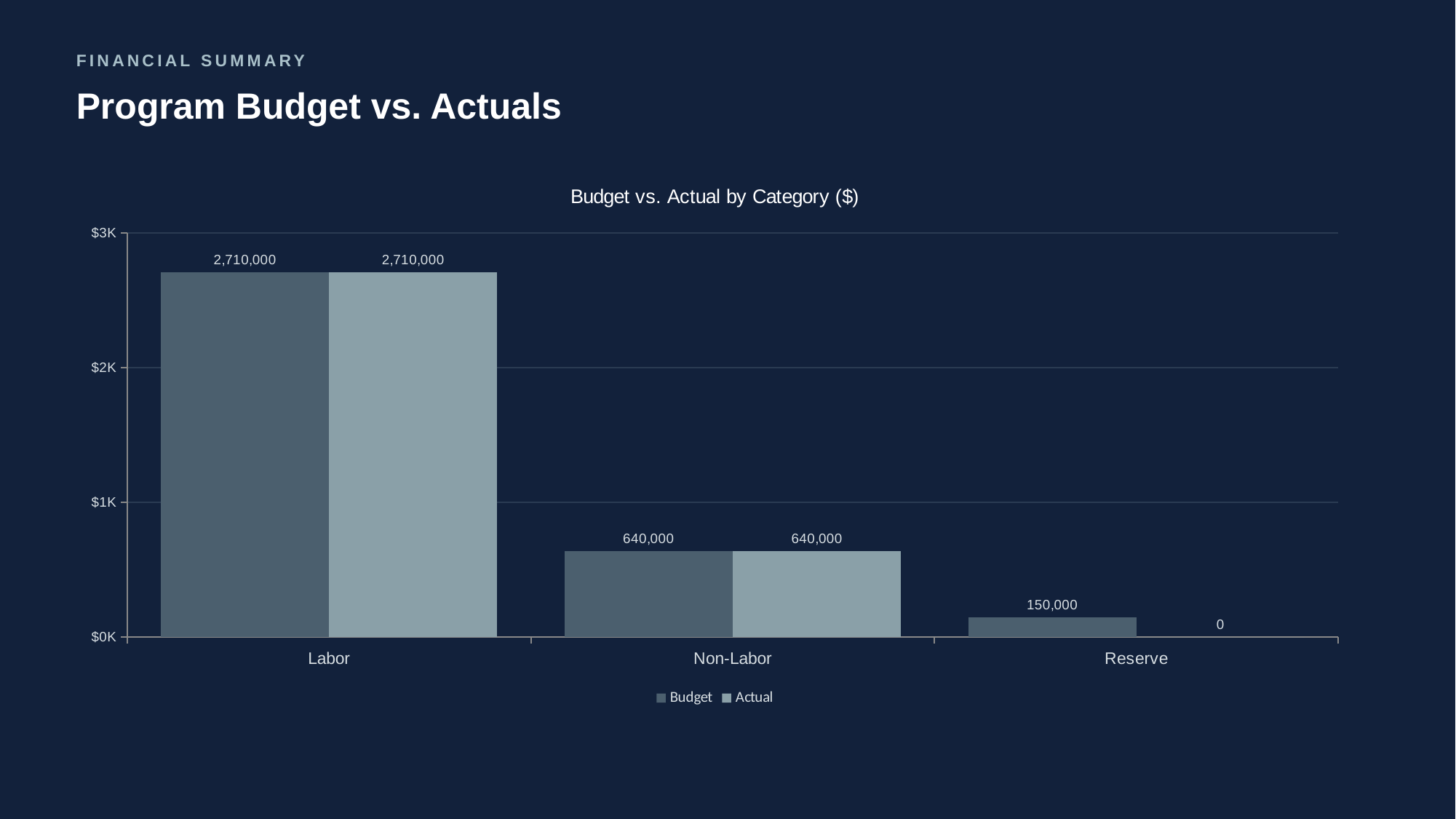
Which category has the lowest Actual value? Reserve What is the difference between the Budget value for Labor and the Budget value for Non-Labor? 2,070,000 What kind of chart is shown on the slide? Bar chart How many series does the legend list? 2 What is the Budget value for Labor? 2,710,000 What is the Budget value for Reserve? 150,000 How many categories are shown on the x axis? 3 What is the difference between the Budget and Actual values for Reserve? 150,000 Which is larger, the Budget value for Non-Labor or the Budget value for Reserve? Non-Labor Which category has the highest Budget value? Labor What is the Actual value for Reserve? 0 What is the Actual value for Non-Labor? 640,000